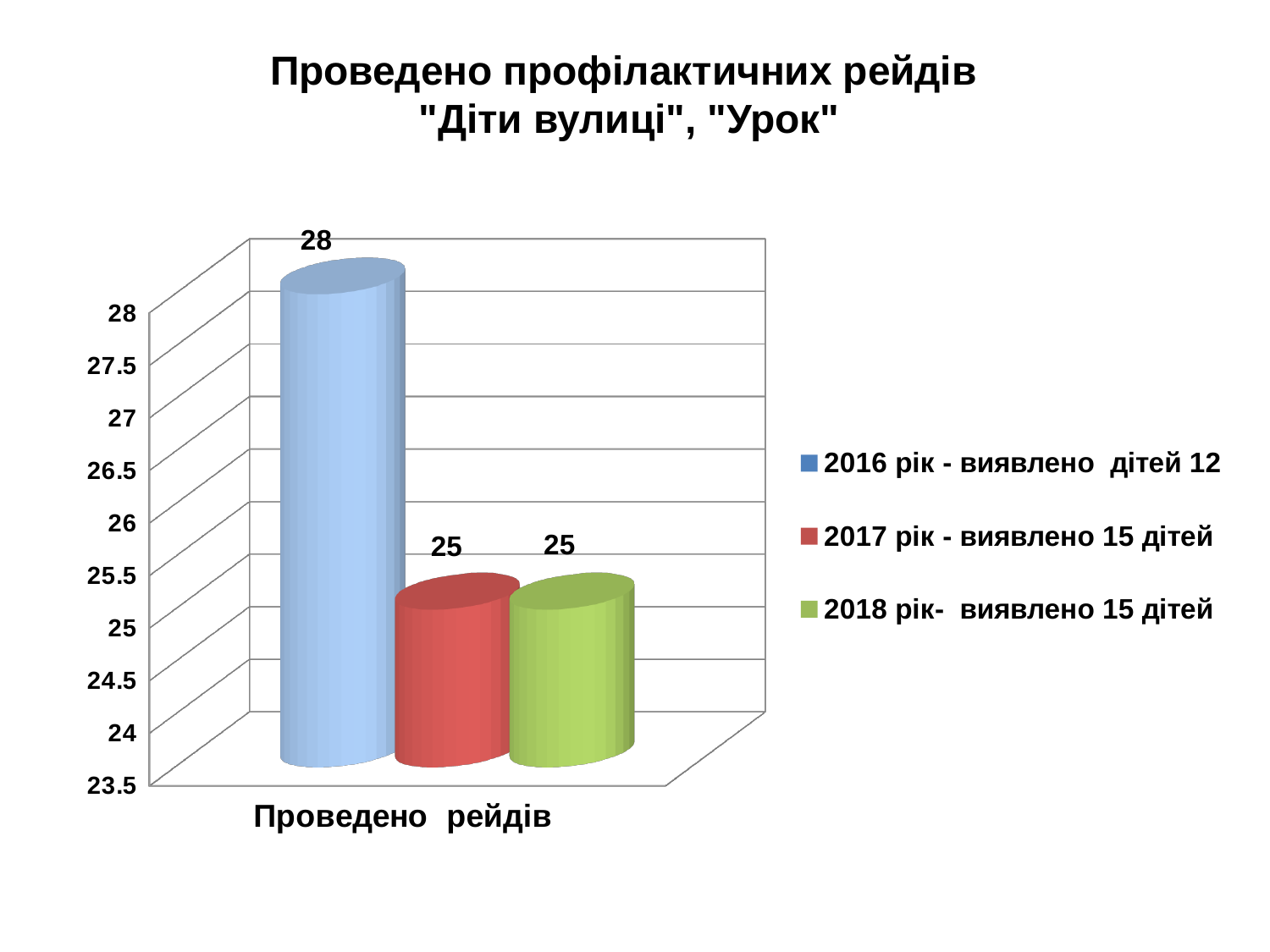
What is the value for the 2018 series (2018 рік- виявлено 15 дітей)? 25 What is the difference between the 2016 value and the 2017 value? 3 What is the category label shown on the x axis? Проведено рейдів Is the value for the 2017 series greater or less than 27? less What is the value for the 2017 series (2017 рік - виявлено 15 дітей)? 25 What colour is the bar for the 2018 series? green Which is larger, the value for 2016 or the value for 2018? 2016 How many bars are plotted on the chart? 3 How many series does the legend list? 3 What is the value for the 2016 series (2016 рік - виявлено дітей 12)? 28 Which series has the highest value? 2016 рік - виявлено дітей 12 What kind of chart is shown on the slide? bar chart